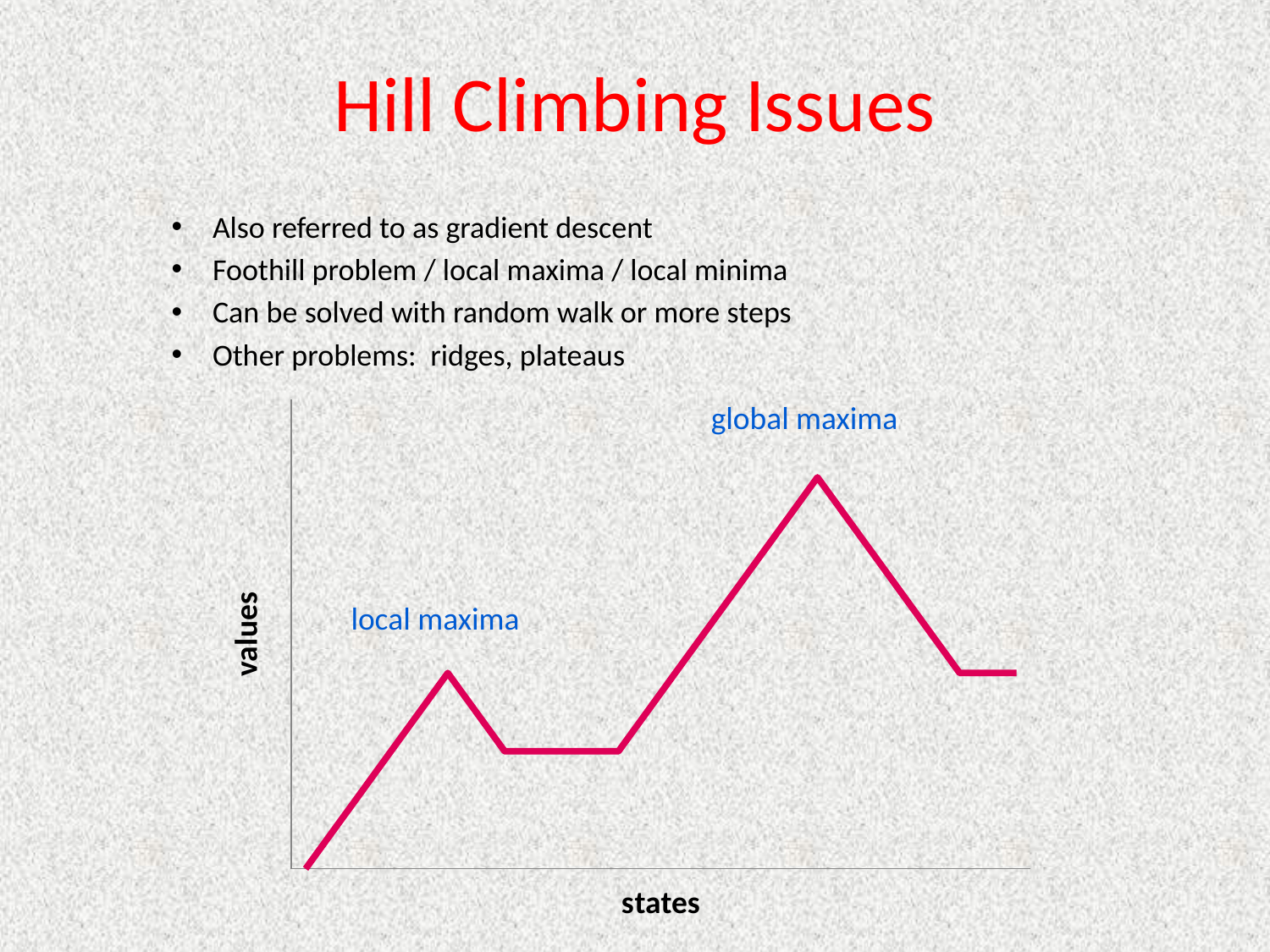
How many lines are plotted on the chart? 1 Which labelled peak on the chart is the highest? global maxima What is the label on the horizontal axis of the chart? states Which labelled peak on the chart is the lowest? local maxima Which labelled peak on the chart is higher, the local maxima or the global maxima? global maxima How many peaks are labelled on the chart? 2 What is the label on the vertical axis of the chart? values Does the line on the chart rise or fall immediately after the global maxima? fall What kind of chart is shown on the slide? line chart Does the line on the chart rise or fall between the start of the x axis and the local maxima? rise